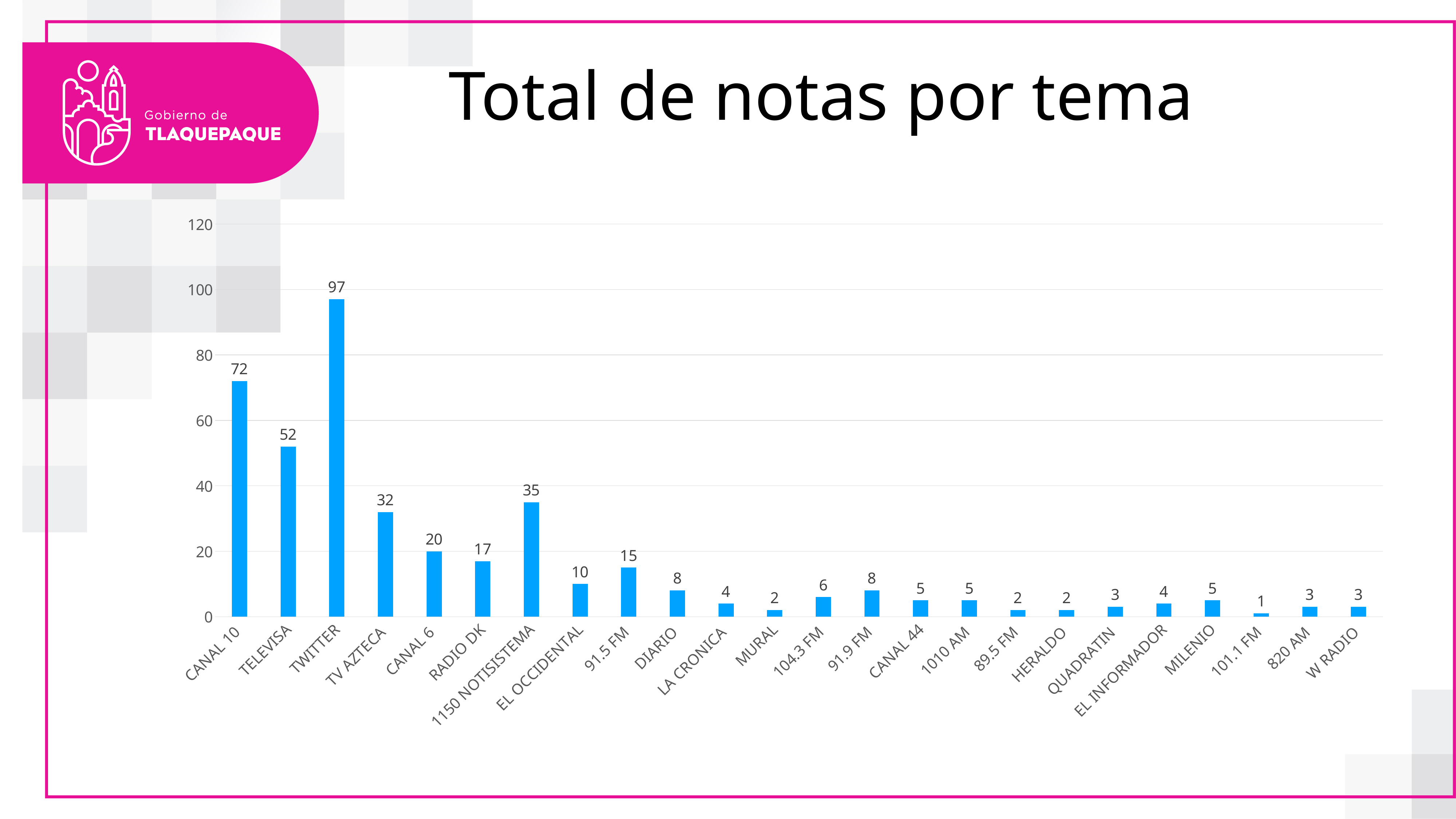
What is the difference between the values for TELEVISA and TV AZTECA? 20 What is the difference between the values for TWITTER and CANAL 10? 25 What is the value for 1150 NOTISISTEMA? 35 What is the title of the chart? Total de notas por tema What is the value for TWITTER? 97 How many categories are shown on the x axis? 24 Which category has the lowest value? 101.1 FM Which category has the highest value? TWITTER Which is larger, the value for CANAL 6 or the value for 91.5 FM? CANAL 6 What is the value for RADIO DK? 17 What kind of chart is shown on the slide? bar chart What is the value for CANAL 10? 72